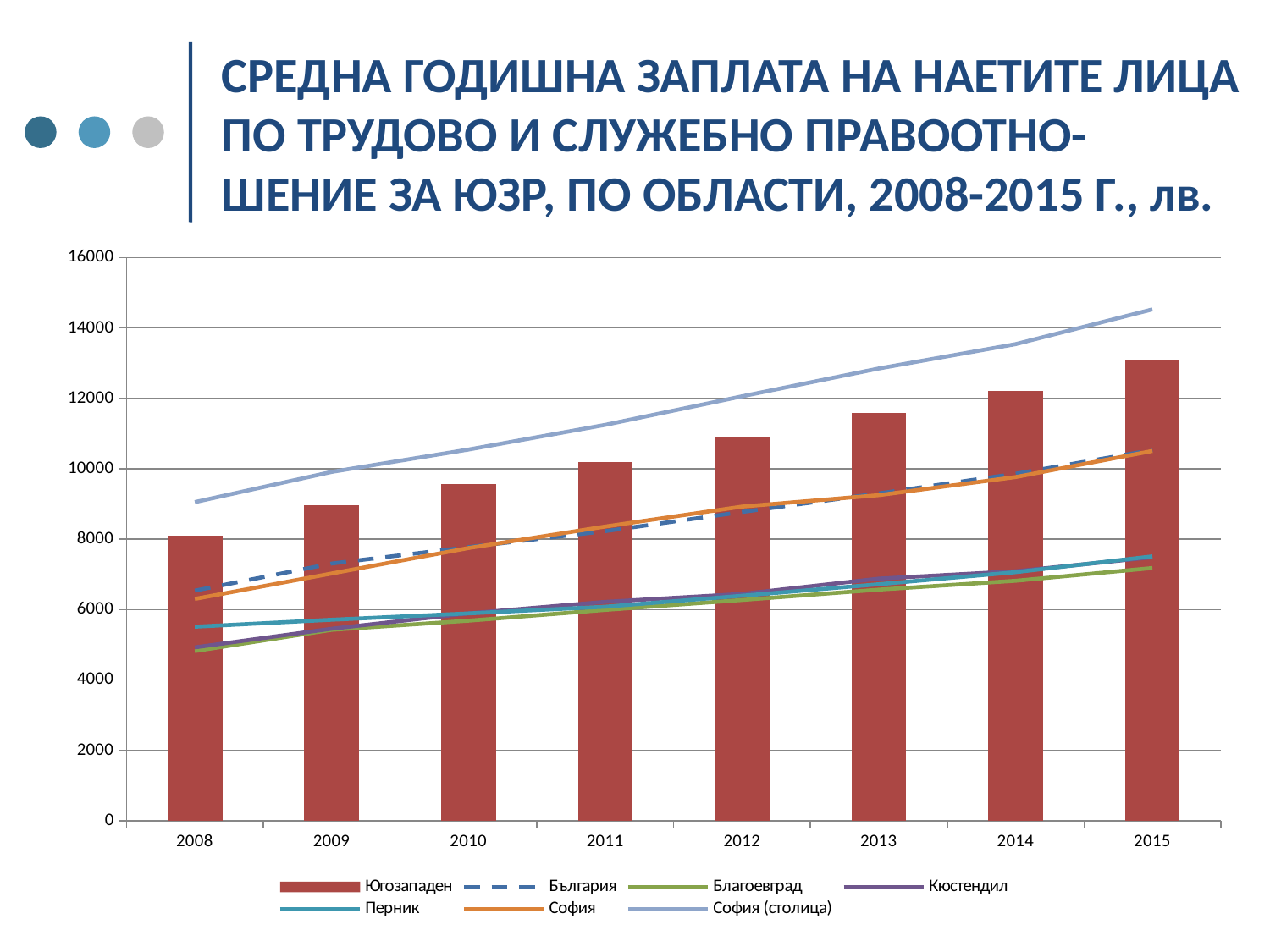
Does the value for Югозападен rise or fall from 2008 to 2015? rise How many series does the legend list? 7 How many years are shown on the x axis of the chart? 8 What kind of chart is shown on the slide? A combined bar and line chart In which year is the Югозападен bar the lowest? 2008 Which series is plotted as bars? Югозападен Is the value for София (столица) in 2015 greater or less than 14000? greater Which series has the highest value in 2015? София (столица) Which series is drawn with a dashed line? България In which year is the Югозападен bar the highest? 2015 Is the value for Югозападен in 2015 greater or less than 12000? greater Is the value for Благоевград in 2008 greater or less than 6000? less